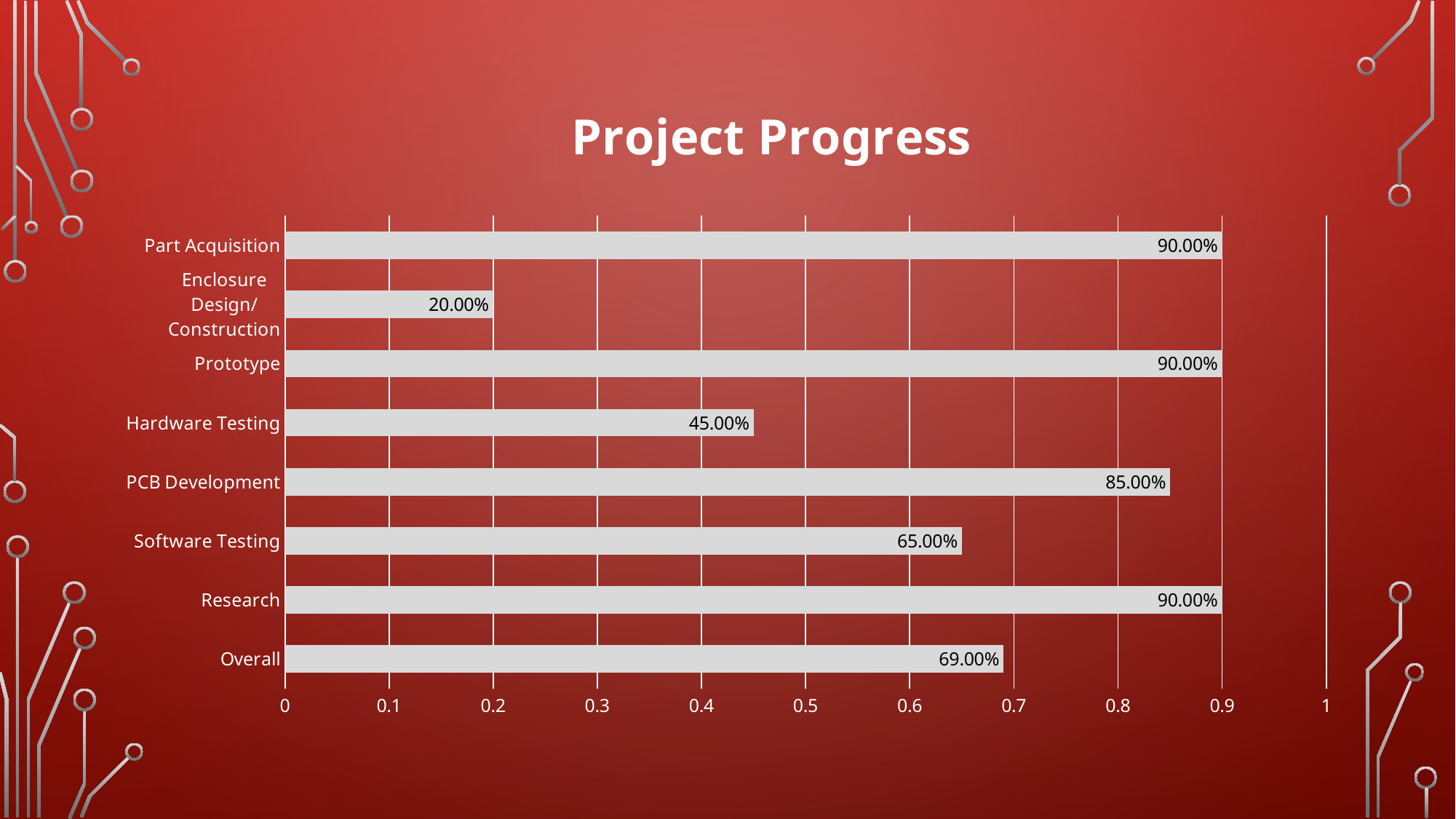
What is the value for Enclosure Design/Construction? 20.00% How many categories are shown in the chart? 8 What is the value for PCB Development? 85.00% Which is larger, the value for Software Testing or the value for Hardware Testing? Software Testing What is the difference between the values for Overall and Hardware Testing? 24.00% What kind of chart is shown on the slide? bar chart What is the difference between the values for PCB Development and Software Testing? 20.00% Is the value for Software Testing greater or less than 0.6? greater What is the value for Overall? 69.00% What is the value for Hardware Testing? 45.00% Which category has the lowest value? Enclosure Design/Construction What is the title of the chart? Project Progress